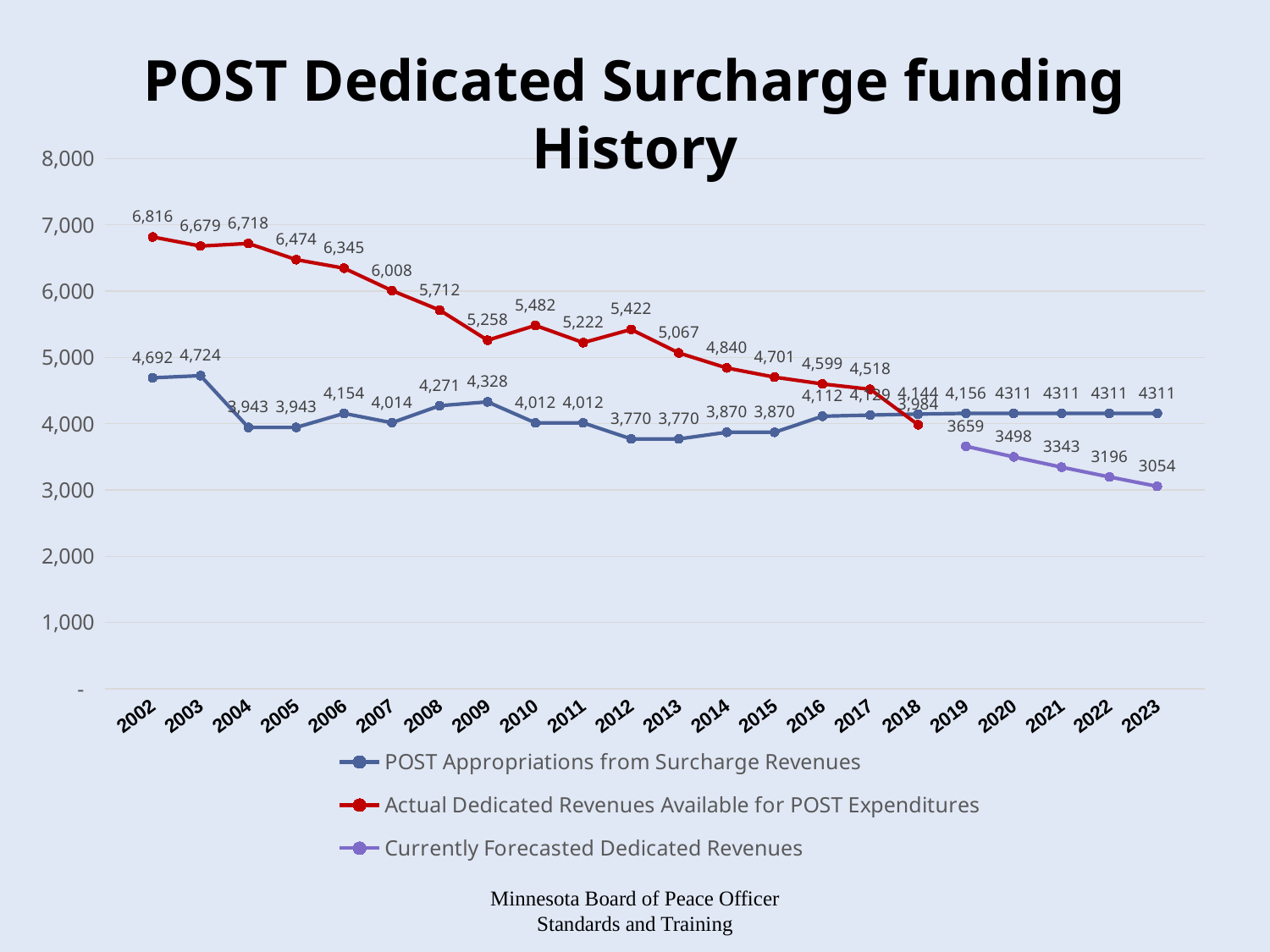
Which is larger in 2012: Actual Dedicated Revenues Available for POST Expenditures or POST Appropriations from Surcharge Revenues? Actual Dedicated Revenues Available for POST Expenditures What is the Currently Forecasted Dedicated Revenues value for 2023? 3054 What is the difference between Actual Dedicated Revenues Available for POST Expenditures and POST Appropriations from Surcharge Revenues in 2007? 1,994 Does the Currently Forecasted Dedicated Revenues series rise or fall from 2019 to 2023? fall What type of chart is shown on the slide? line chart What is the title of the chart? POST Dedicated Surcharge funding History What is the value of Actual Dedicated Revenues Available for POST Expenditures in 2002? 6,816 How many years are shown on the x axis? 22 In which year is the Currently Forecasted Dedicated Revenues series lowest? 2023 In which year is the Actual Dedicated Revenues Available for POST Expenditures series highest? 2002 What is the value of POST Appropriations from Surcharge Revenues in 2009? 4,328 How many series does the legend list? 3